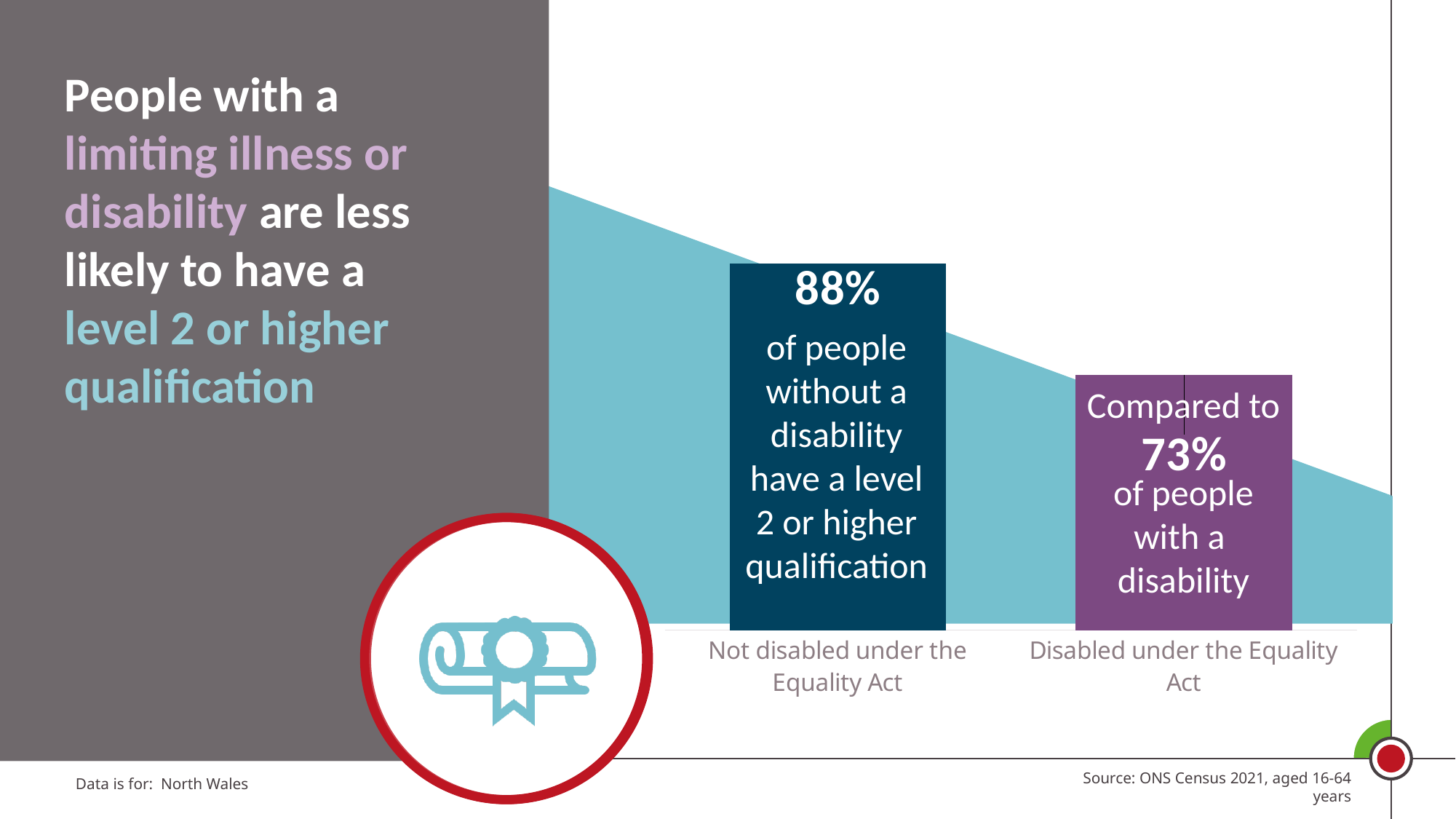
What is the source of the data shown in the chart? ONS Census 2021, aged 16-64 years How many categories are shown in the chart? 2 Which category has the higher value? Not disabled under the Equality Act Is the value for people disabled under the Equality Act larger or smaller than the value for people not disabled under the Equality Act? smaller What percentage of people not disabled under the Equality Act have a level 2 or higher qualification? 88% Do the values rise or fall from left to right across the chart? fall What is the difference in percentage points between the two bars? 15 Which category has the lower value? Disabled under the Equality Act What area is the data on the slide for? North Wales What kind of chart is shown on the slide? bar chart What percentage of people disabled under the Equality Act have a level 2 or higher qualification? 73%